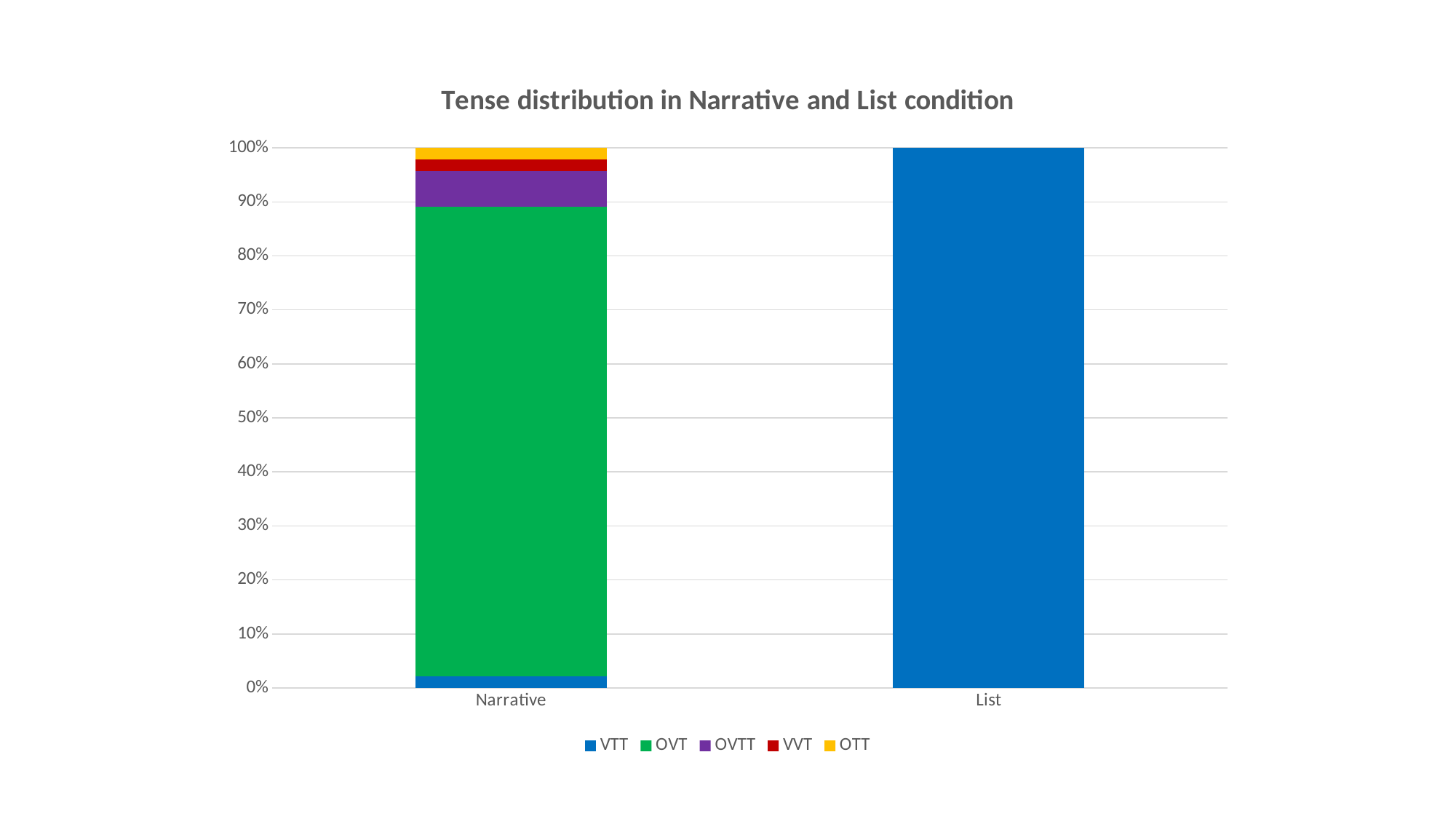
Which series makes up the entire List bar? VTT How many series does the legend list? 5 Is the value for OVT in the Narrative condition greater or less than 80%? greater How many categories are shown on the x axis? 2 Which condition has the larger VTT share, Narrative or List? List Which is larger in the Narrative condition, OVT or OVTT? OVT Is the value for OVTT in the Narrative condition greater or less than 20%? less What is the value of VTT for the List condition? 100% Which series takes the largest share of the Narrative bar? OVT What is the title of the chart? Tense distribution in Narrative and List condition What kind of chart is shown on the slide? Stacked bar chart Is the value for VTT in the Narrative condition greater or less than 10%? less